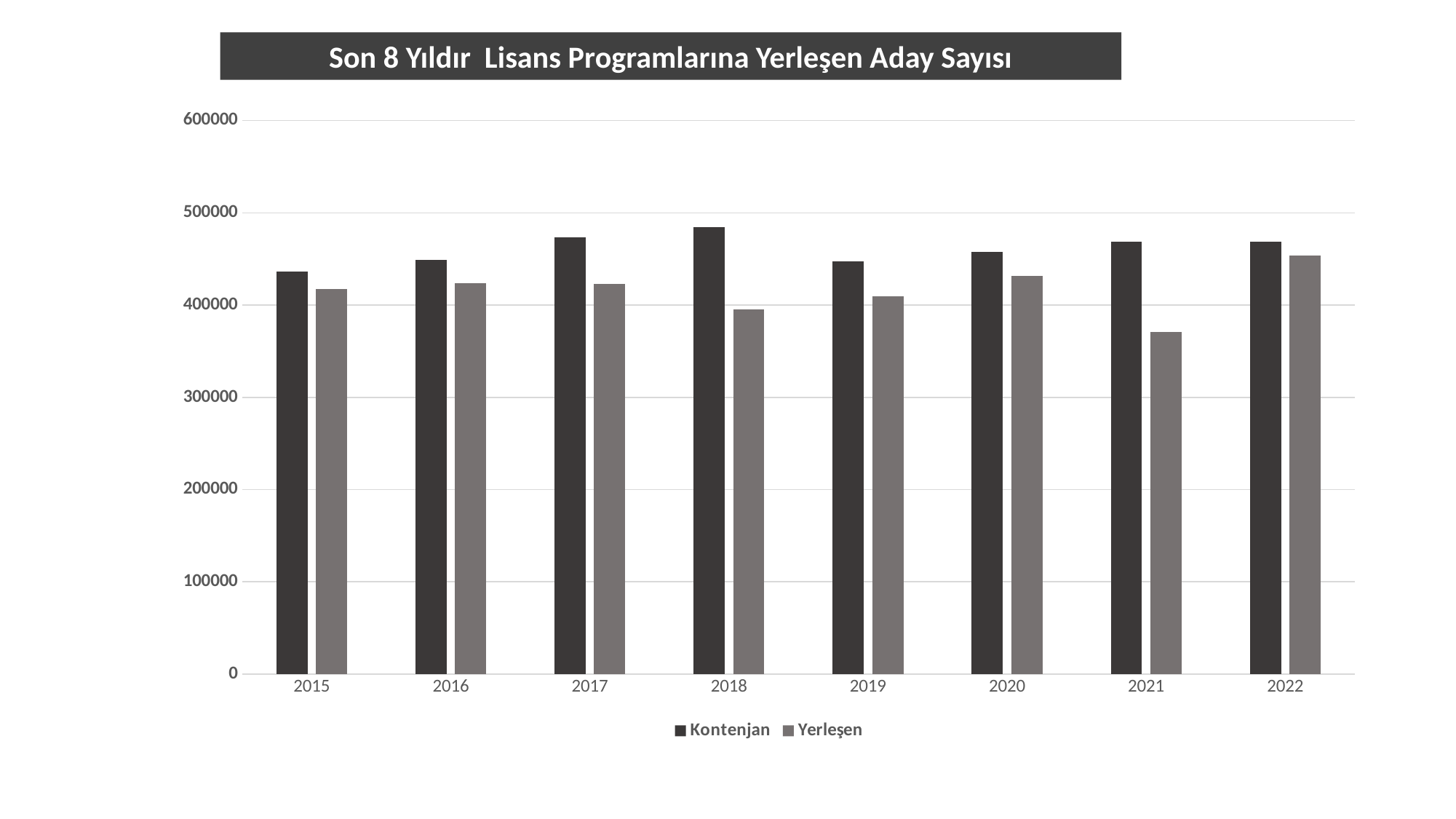
Is the Yerleşen value for 2021 greater or less than 400000? less In which year is the Yerleşen value highest? 2022 How many years are shown on the x axis of the chart? 8 What kind of chart is shown on the slide? Bar chart What is the title of the chart? Son 8 Yıldır Lisans Programlarına Yerleşen Aday Sayısı Is the Kontenjan value for 2018 greater or less than 500000? less In which year is the Yerleşen value lowest? 2021 Is the Yerleşen value for 2022 greater or less than 400000? greater In which year is the Kontenjan value highest? 2018 What are the two series named in the legend? Kontenjan and Yerleşen In 2021, which is larger, Kontenjan or Yerleşen? Kontenjan How many series does the legend list? 2